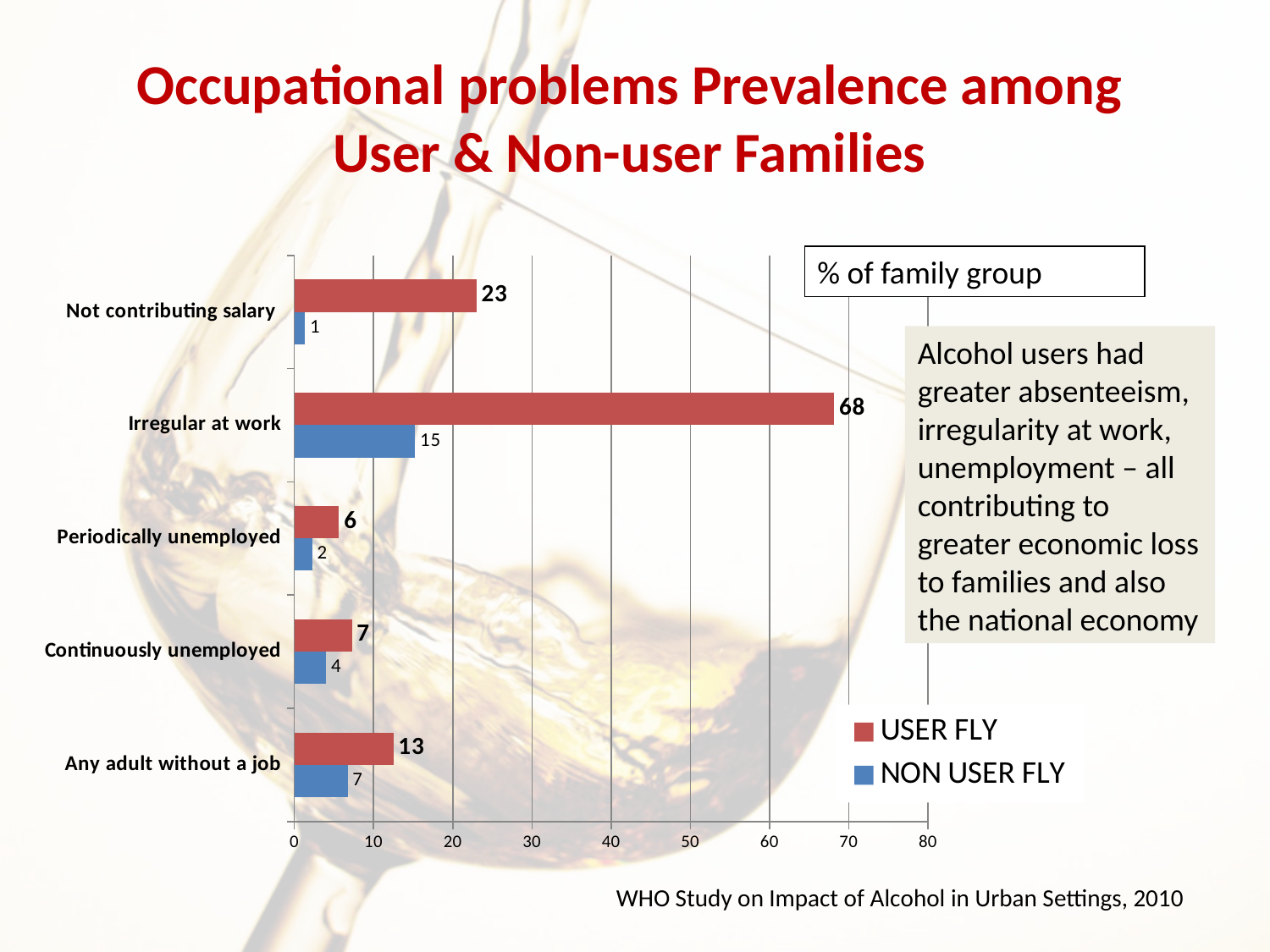
What is the difference between the USER FLY and NON USER FLY values for Irregular at work? 53 What is the NON USER FLY value for Not contributing salary? 1 What kind of chart is shown on the slide? Bar chart What is the USER FLY value for Any adult without a job? 13 Is the USER FLY value for Not contributing salary greater or less than 20? greater Which category has the lowest NON USER FLY value? Not contributing salary Which colour represents the NON USER FLY series? Blue Which category has the highest USER FLY value? Irregular at work How many series does the legend list? 2 Which is larger for Continuously unemployed: the USER FLY value or the NON USER FLY value? USER FLY How many categories are shown on the chart? 5 What is the USER FLY value for Irregular at work? 68